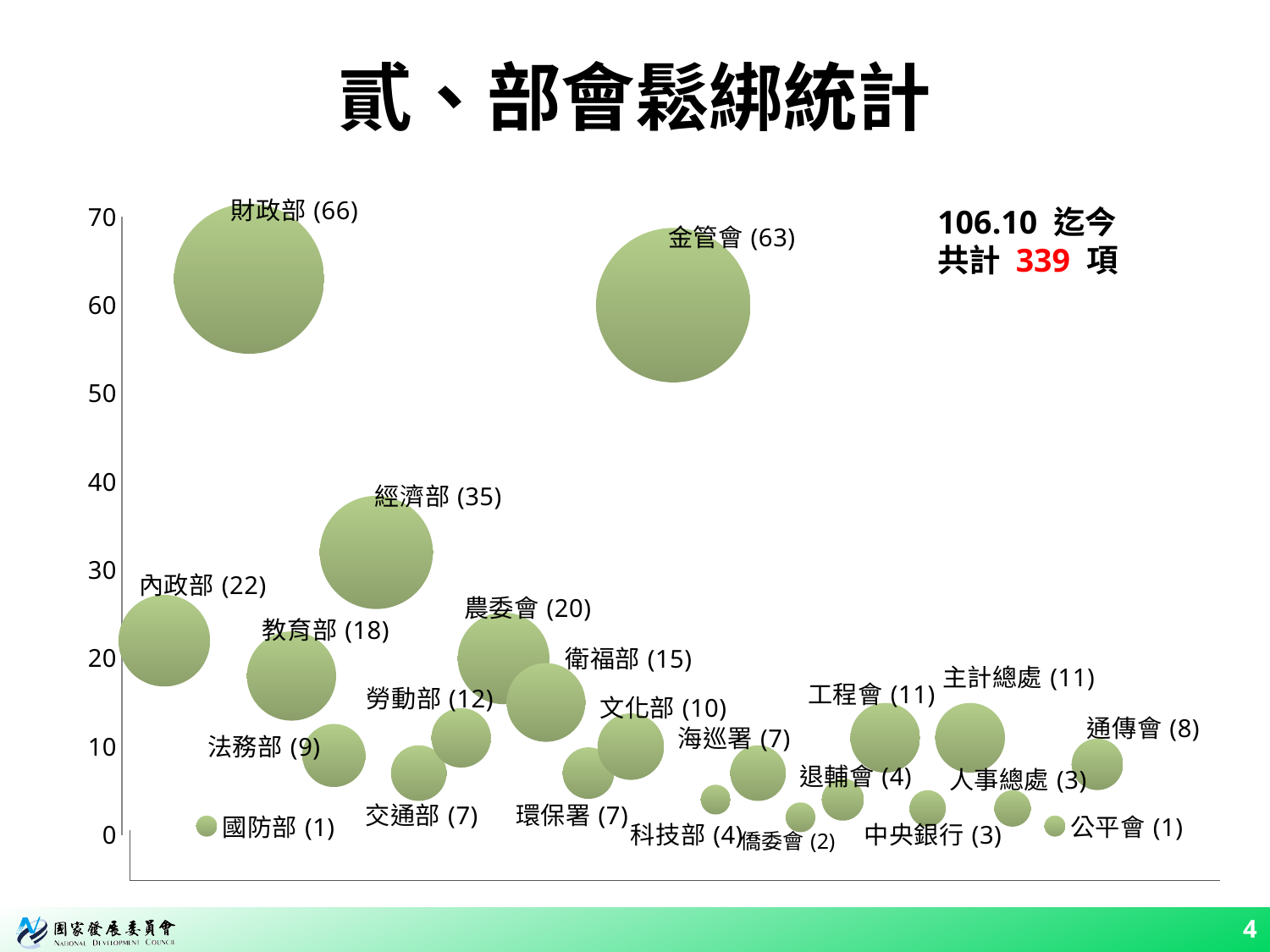
What total number of items does the slide state for all ministries combined? 339 Which has a larger value, 勞動部 or 文化部? 勞動部 What is the difference between the values for 經濟部 and 內政部? 13 What is the value shown for 衛福部? 15 What kind of chart is shown on the slide? Bubble chart What is the difference between the values for 財政部 and 金管會? 3 Which ministry has the highest value in the chart? 財政部 (66) Which has a larger value, 農委會 or 教育部? 農委會 What is the value shown for 金管會? 63 What is the value shown for 財政部? 66 How many ministries or agencies are plotted in the chart? 23 What is the value shown for 經濟部? 35